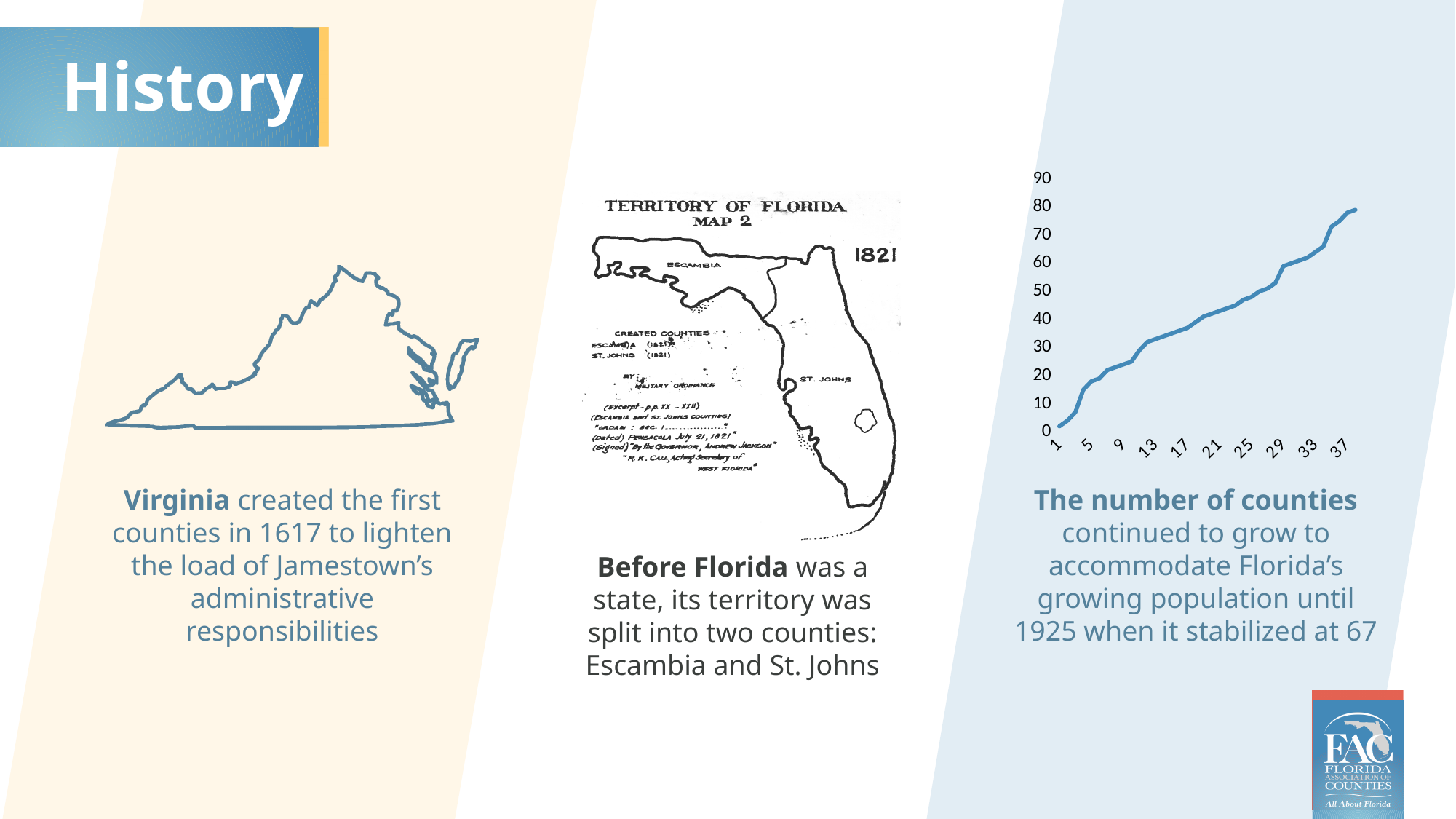
In the line chart on the right, is the value at x = 21 greater or less than 40? greater In the line chart on the right, is the value at x = 13 greater or less than 40? less In the line chart on the right, is the value at x = 1 greater or less than 10? less In the line chart on the right, what is the highest value labelled on the y axis? 90 In the line chart on the right, do the values rise or fall as the x axis increases? rise In the line chart on the right, at which end of the x axis is the line at its lowest? the left end (x = 1) In the line chart on the right, which is larger, the value at x = 5 or the value at x = 33? x = 33 In the line chart on the right, how many labels are printed along the x axis? 10 What kind of chart is shown on the right side of the slide? line chart